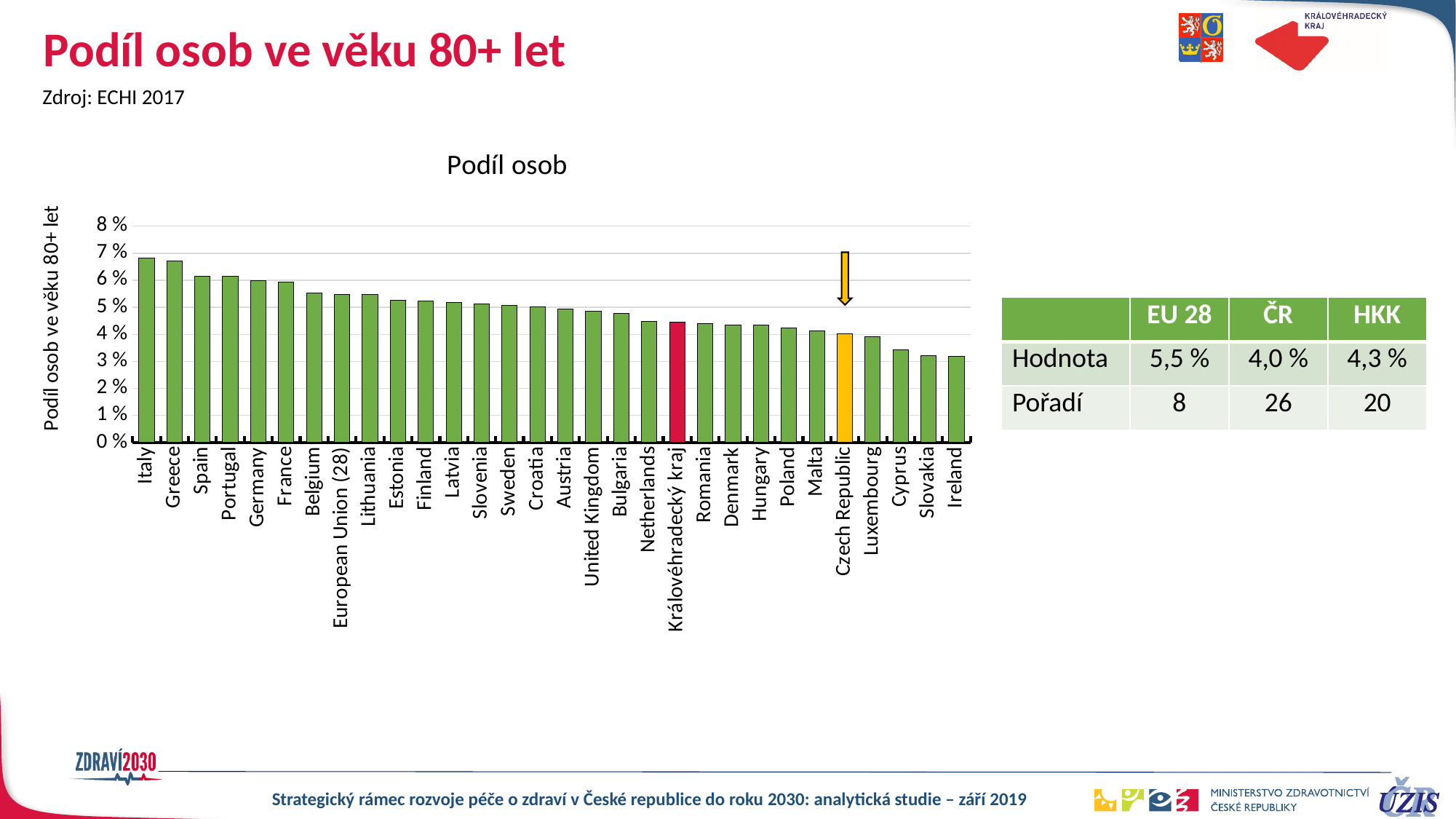
Is the value for Ireland greater or less than 4 %? less Which has a larger value, Spain or Ireland? Spain What colour is the bar for Czech Republic? yellow According to the slide, what is the value for European Union (28)? 5,5 % What is the title of the chart? Podíl osob According to the slide, what is the value for Královéhradecký kraj? 4,3 % What kind of chart is shown on the slide? bar chart Is the value for Italy greater or less than 6 %? greater What is the difference between the value for European Union (28) and the value for Czech Republic? 1,5 % According to the slide, what is the value for Czech Republic? 4,0 % How many countries/regions are plotted on the x axis of the chart? 30 Do the values rise or fall from left to right along the x axis? fall